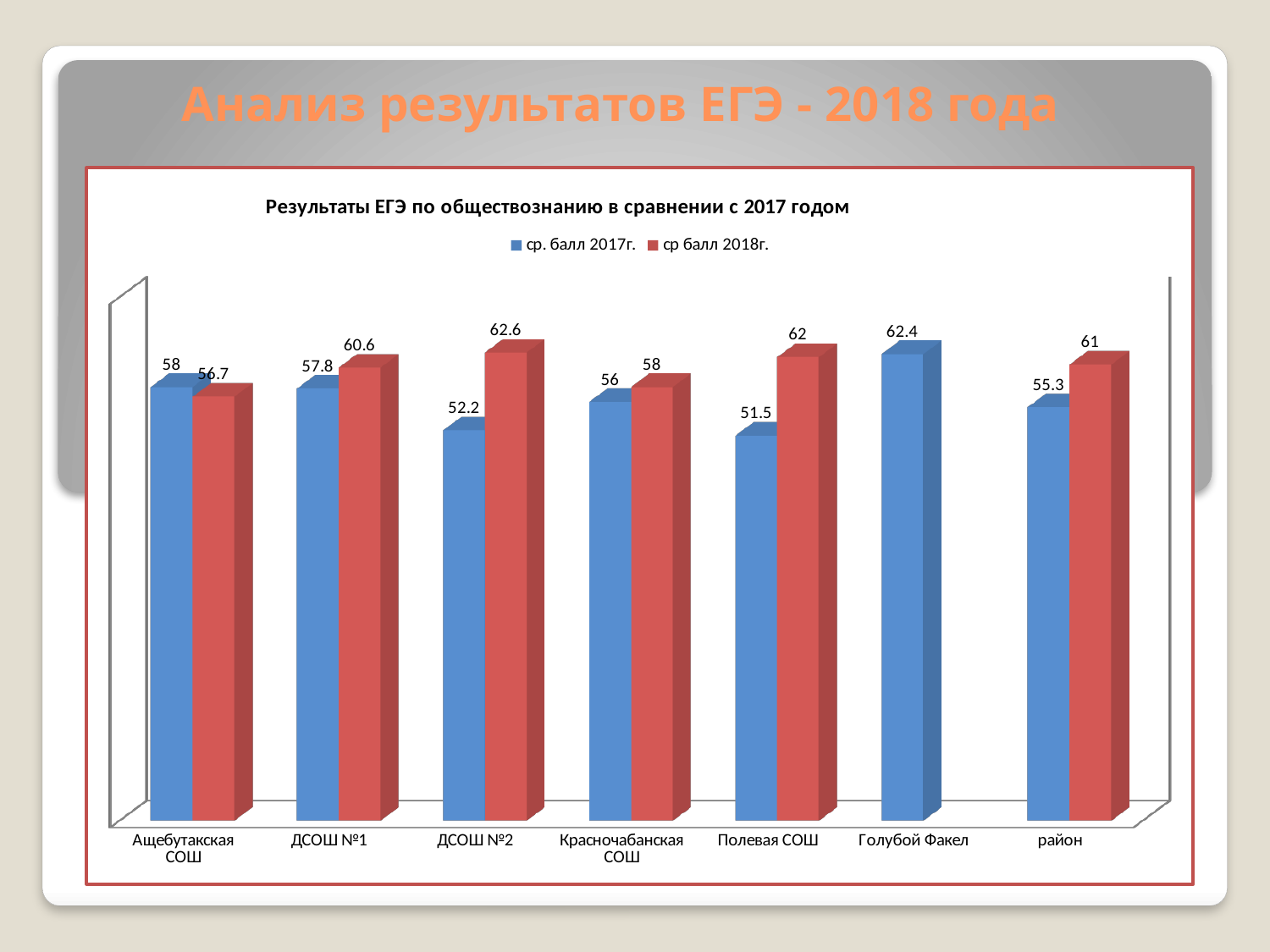
How many series does the legend list? 2 What is the average score for 2017 (ср. балл 2017г.) at ДСОШ №2? 52.2 What kind of chart is shown? Bar chart Which category has the lowest 2018 average score? Ащебутакская СОШ What is the difference between the 2018 and 2017 average scores at ДСОШ №2? 10.4 Which category has the lowest 2017 average score? Полевая СОШ What is the 2018 average score for район? 61 At Ащебутакская СОШ, which is larger: the 2017 average score or the 2018 average score? 2017 average score What is the title of the chart? Результаты ЕГЭ по обществознанию в сравнении с 2017 годом What is the average score for 2018 (ср балл 2018г.) at Полевая СОШ? 62 Which category has the highest 2017 average score? Голубой Факел How many categories are shown on the x axis? 7